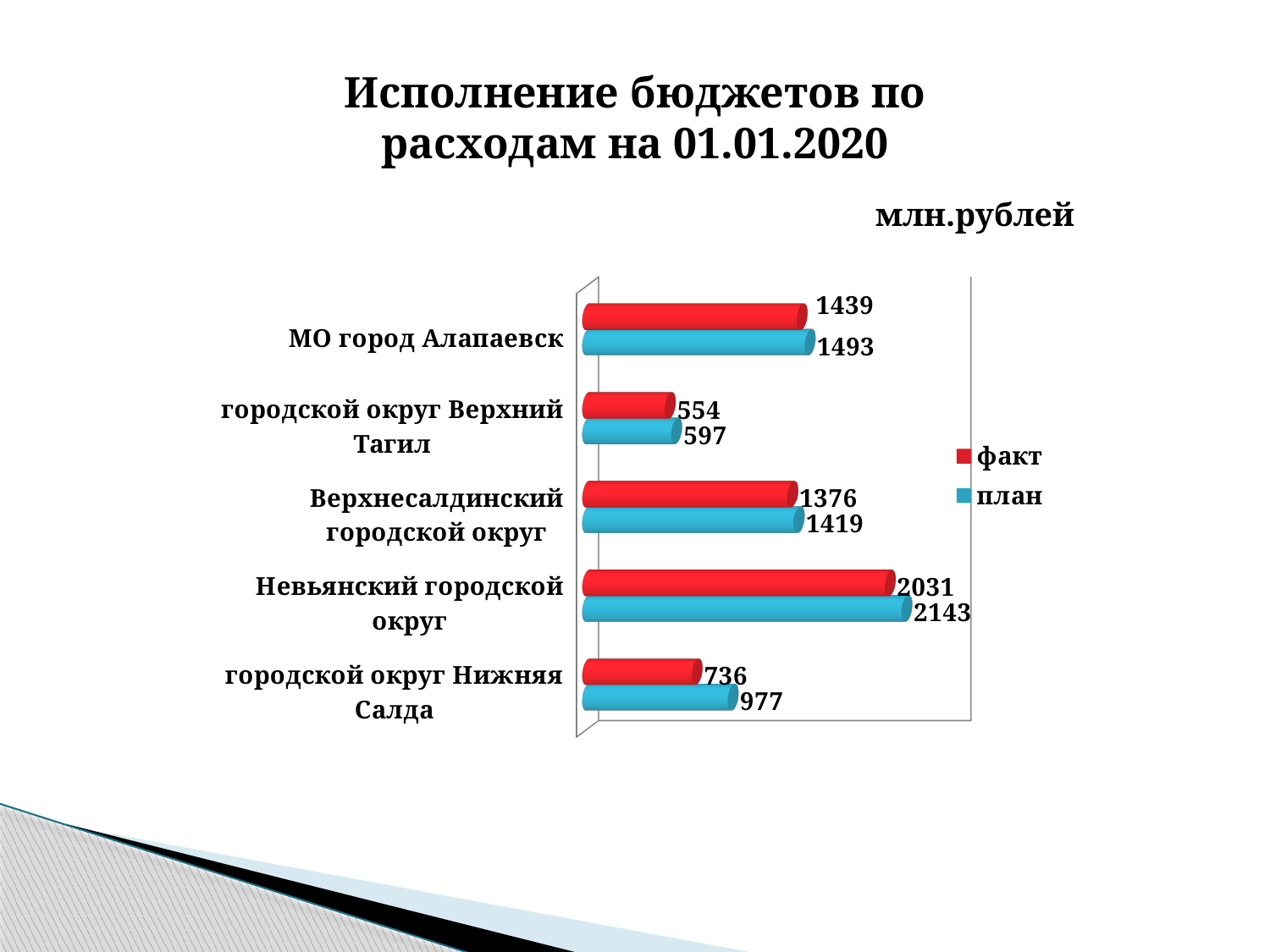
How many series does the legend list? 2 Which is larger for городской округ Верхний Тагил, the факт value or the план value? план What is the difference between the план and факт values for городской округ Нижняя Салда? 241 Which category has the highest план value? Невьянский городской округ What kind of chart is shown on the slide? bar chart Which category has the lowest факт value? городской округ Верхний Тагил How many categories are shown on the chart? 5 What is the план value for Верхнесалдинский городской округ? 1419 What unit is stated above the chart? млн.рублей What is the план value for городской округ Нижняя Салда? 977 What is the difference between the план and факт values for Невьянский городской округ? 112 What is the факт value for МО город Алапаевск? 1439